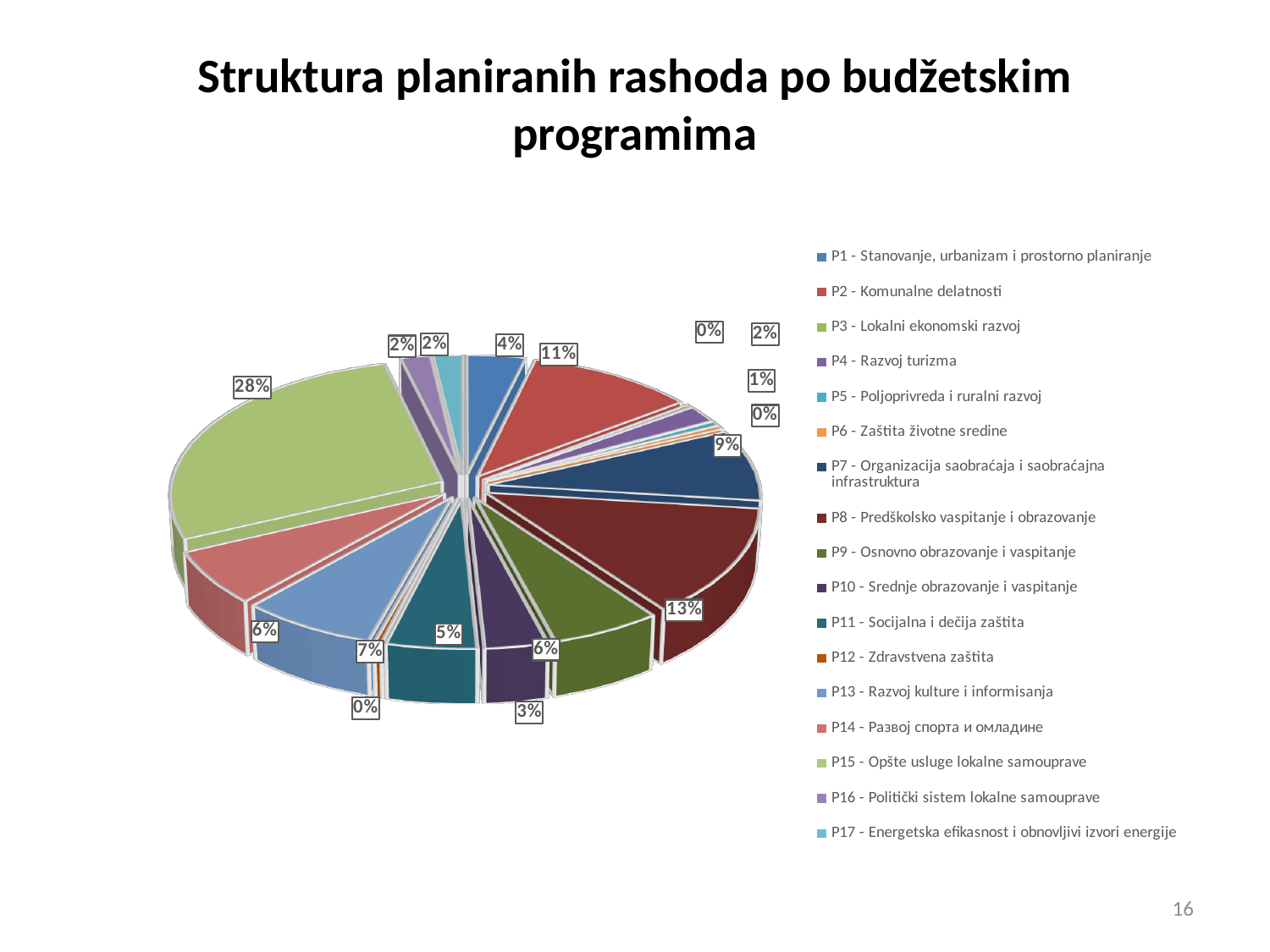
How many categories does the legend list? 17 What share of planned expenditures goes to P7 - Organizacija saobraćaja i saobraćajna infrastruktura? 9% What is the title of the chart? Struktura planiranih rashoda po budžetskim programima By how many percentage points does the share of P15 - Opšte usluge lokalne samouprave exceed that of P8 - Predškolsko vaspitanje i obrazovanje? 15 What share of planned expenditures goes to P15 - Opšte usluge lokalne samouprave? 28% What share of planned expenditures goes to P8 - Predškolsko vaspitanje i obrazovanje? 13% What share of planned expenditures goes to P2 - Komunalne delatnosti? 11% Which has a larger share: P2 - Komunalne delatnosti or P8 - Predškolsko vaspitanje i obrazovanje? P8 - Predškolsko vaspitanje i obrazovanje Which has a larger share: P15 - Opšte usluge lokalne samouprave or P2 - Komunalne delatnosti? P15 - Opšte usluge lokalne samouprave What share of planned expenditures goes to P1 - Stanovanje, urbanizam i prostorno planiranje? 4% What kind of chart is shown on the slide? pie chart Which program has the largest share of planned expenditures? P15 - Opšte usluge lokalne samouprave